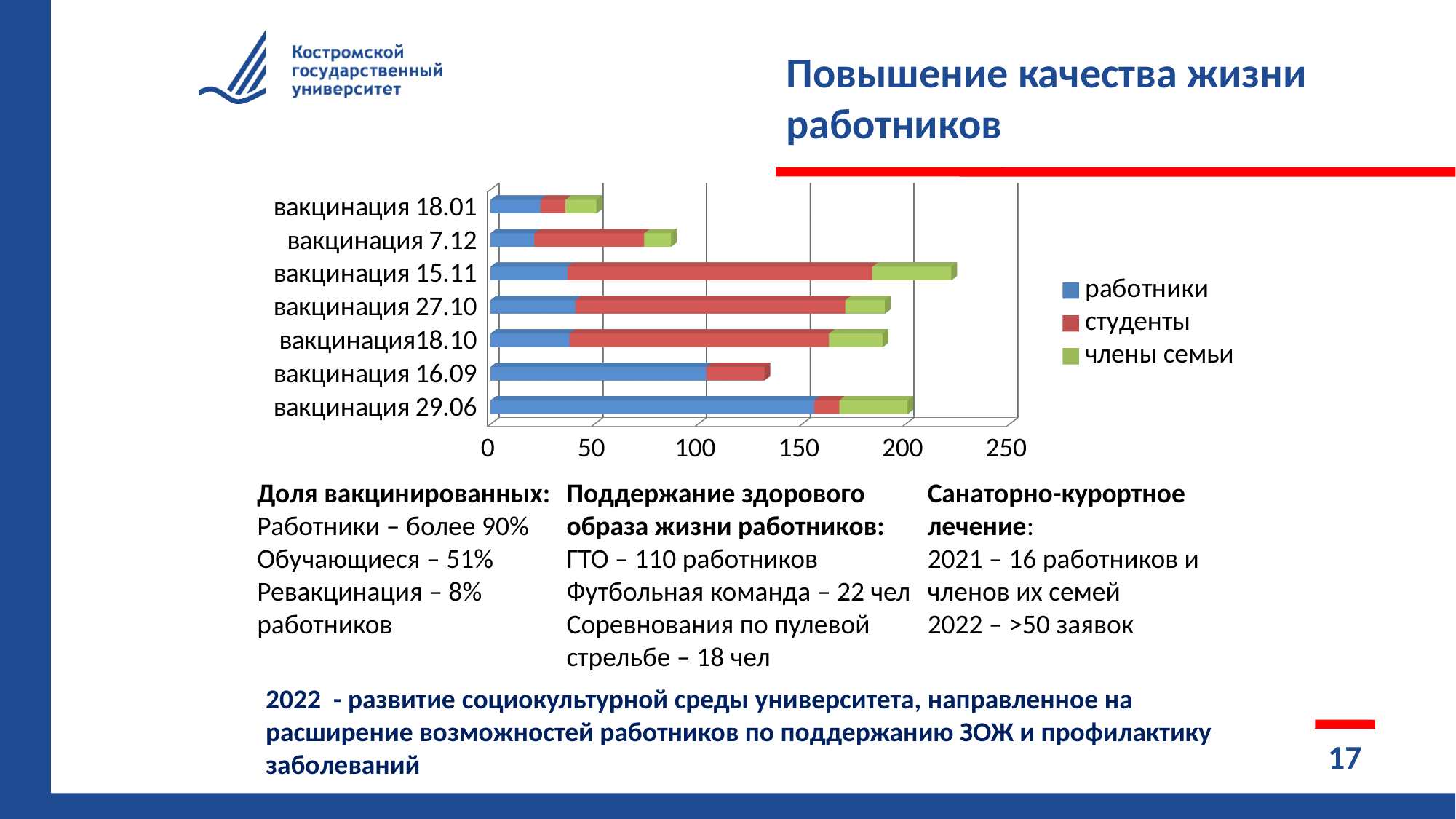
How many categories (vaccination dates) are shown on the chart? 7 Which has the longer total bar: вакцинация 16.09 or вакцинация 29.06? вакцинация 29.06 Is the total bar for вакцинация 15.11 greater or less than 200? greater Which vaccination date has no 'члены семьи' segment in its bar? вакцинация 16.09 What kind of chart is shown on the slide? bar chart Which series are listed in the chart legend? работники, студенты, члены семьи Which vaccination date has the largest 'работники' segment? вакцинация 29.06 How many series does the chart legend list? 3 Which vaccination date has the shortest total bar? вакцинация 18.01 Is the total bar for вакцинация 7.12 greater or less than 100? less Which vaccination date has the longest total bar? вакцинация 15.11